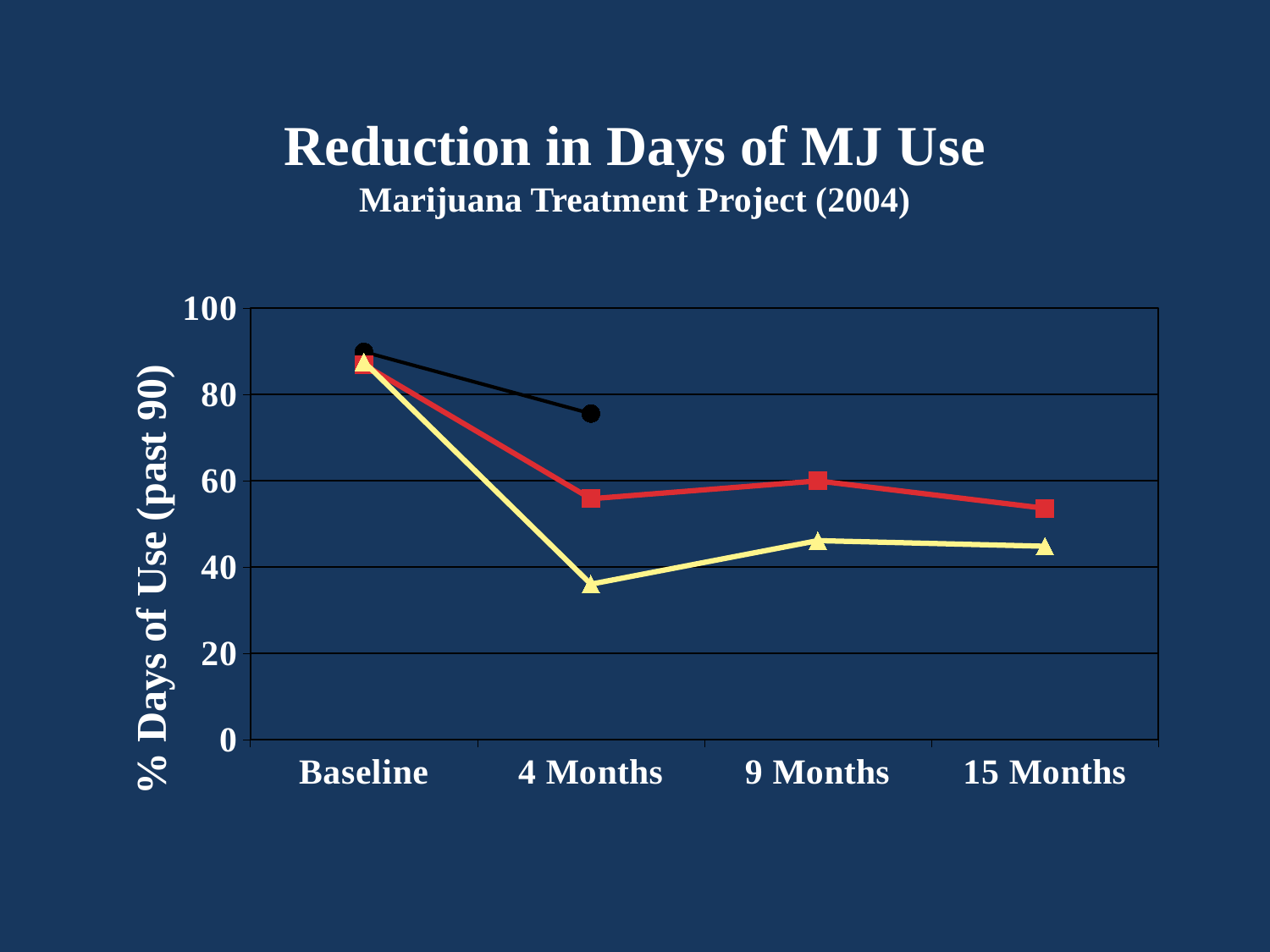
Is the value of the black circle line at 4 Months greater or less than 60? greater How many lines are plotted on the chart? 3 Is the value of the yellow triangle line at 4 Months greater or less than 40? less What is the label of the y axis? % Days of Use (past 90) Do the values of the yellow triangle line rise or fall from Baseline to 4 Months? fall Is the value of the red square line at 15 Months greater or less than 60? less How many time points are shown on the x axis? 4 At 4 Months, which line has the higher value, the black circle line or the red square line? black circle line At 4 Months, which line has the higher value, the red square line or the yellow triangle line? red square line What kind of chart is shown on the slide? line chart